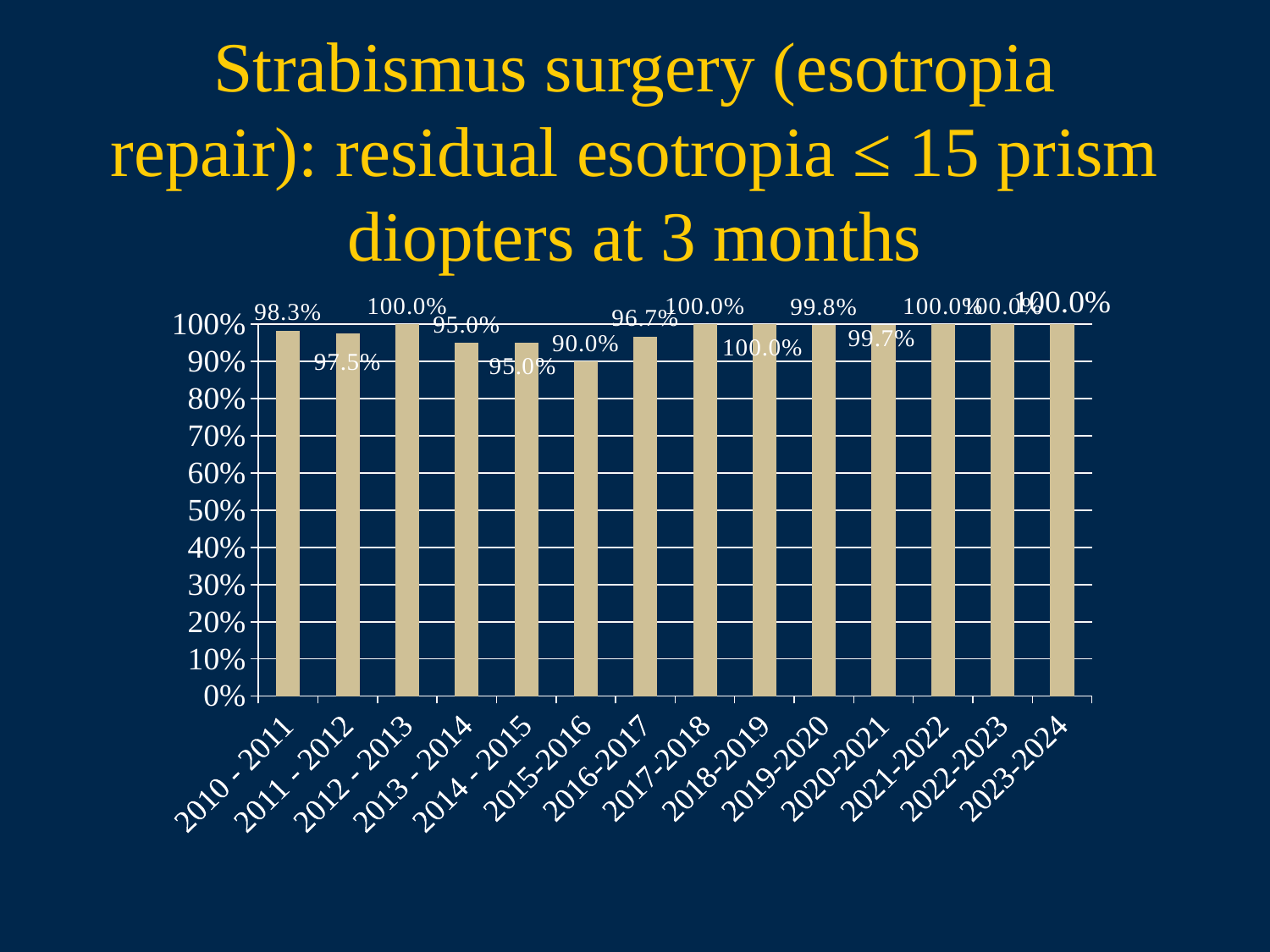
What is the value for 2011 - 2012? 97.5% What is the value for 2015-2016? 90.0% What is the difference between the values for 2019-2020 and 2020-2021? 0.1 percentage points Which year has the lowest value? 2015-2016 What is the title of the slide? Strabismus surgery (esotropia repair): residual esotropia ≤ 15 prism diopters at 3 months What kind of chart is shown on the slide? Bar chart What is the value for 2016-2017? 96.7% What is the difference between the values for 2010 - 2011 and 2015-2016? 8.3 percentage points How many year categories are shown on the x axis? 14 What is the value for 2019-2020? 99.8% Which is larger, the value for 2011 - 2012 or the value for 2013 - 2014? 2011 - 2012 What is the value for 2010 - 2011? 98.3%